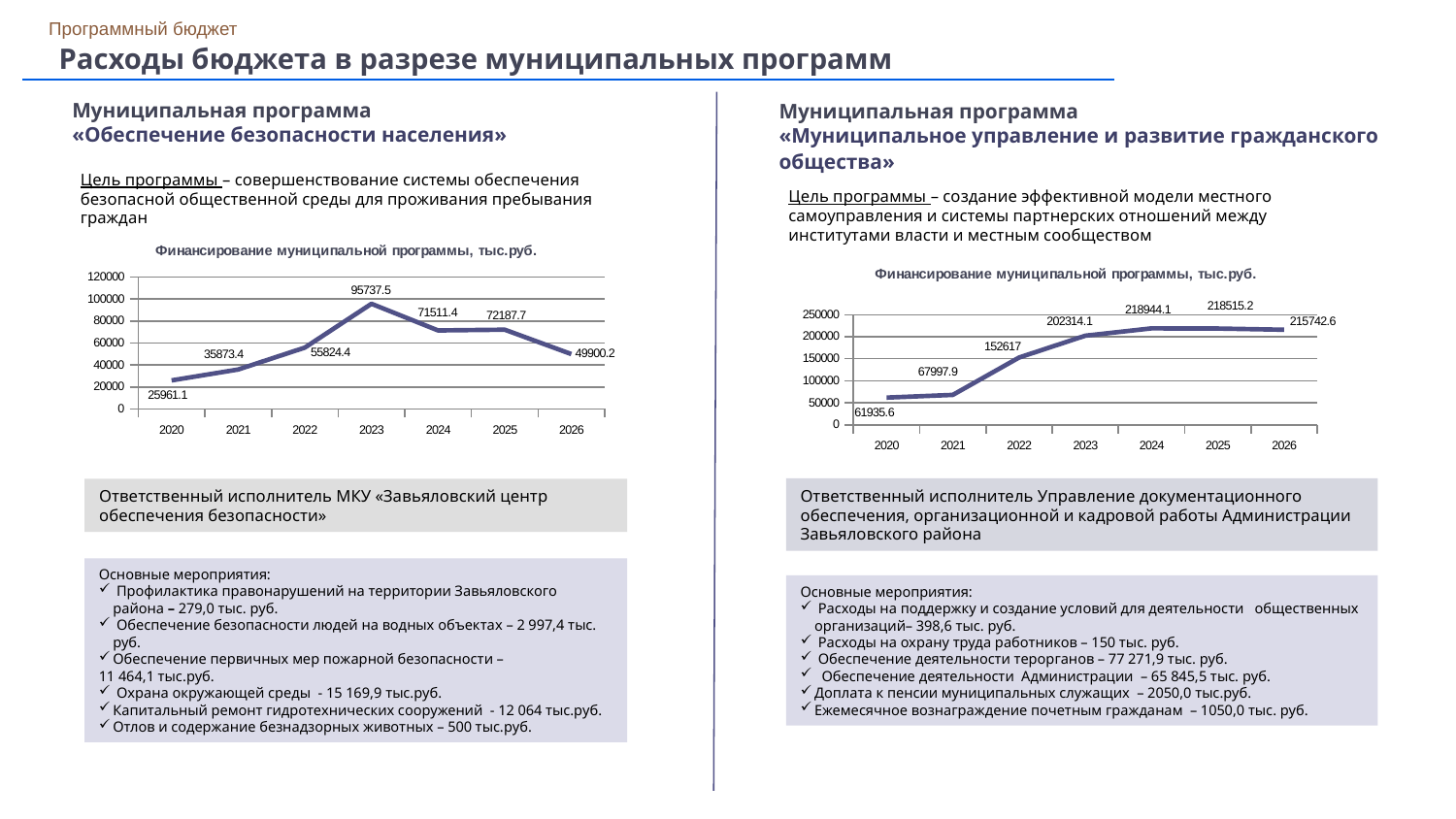
On the right chart, what is the value for 2020? 61935.6 On the left chart, what is the value for 2026? 49900.2 On the left chart, which year has the highest value? 2023 On the right chart, is the value for 2024 greater or less than 200000? greater On the right chart, what is the difference between the values for 2023 and 2022? 49697.1 How many years are plotted on the right chart? 7 What kind of chart is the left chart? line chart On the left chart, which is larger, the value for 2022 or the value for 2026? 2022 On the left chart, which year has the lowest value? 2020 On the left chart, what is the value for 2023? 95737.5 On the left chart, what is the difference between the values for 2023 and 2022? 39913.1 On the right chart, what is the value for 2022? 152617